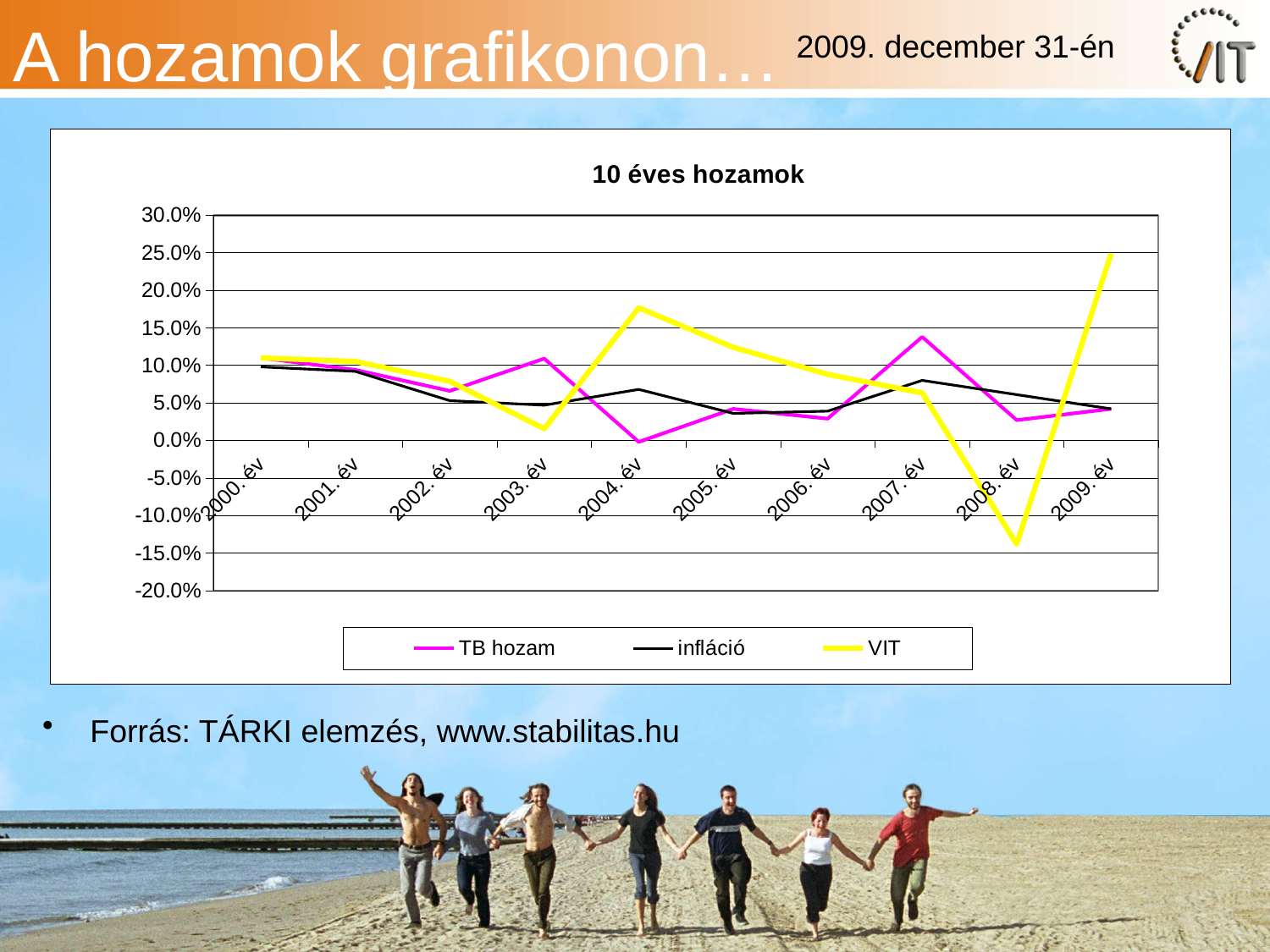
Is the VIT value for 2008. év greater or less than -10.0%? less How many years are shown on the x axis? 10 In which year is the VIT value lowest? 2008. év What is the title of the chart? 10 éves hozamok In 2004. év, which is larger, VIT or TB hozam? VIT How many series does the legend list? 3 Which series is drawn in yellow? VIT In which year is the TB hozam value highest? 2007. év In which year is the VIT value highest? 2009. év Does the VIT line rise or fall from 2004. év to 2006. év? fall Is the VIT value for 2009. év greater or less than 20.0%? greater What kind of chart is shown on the slide? line chart